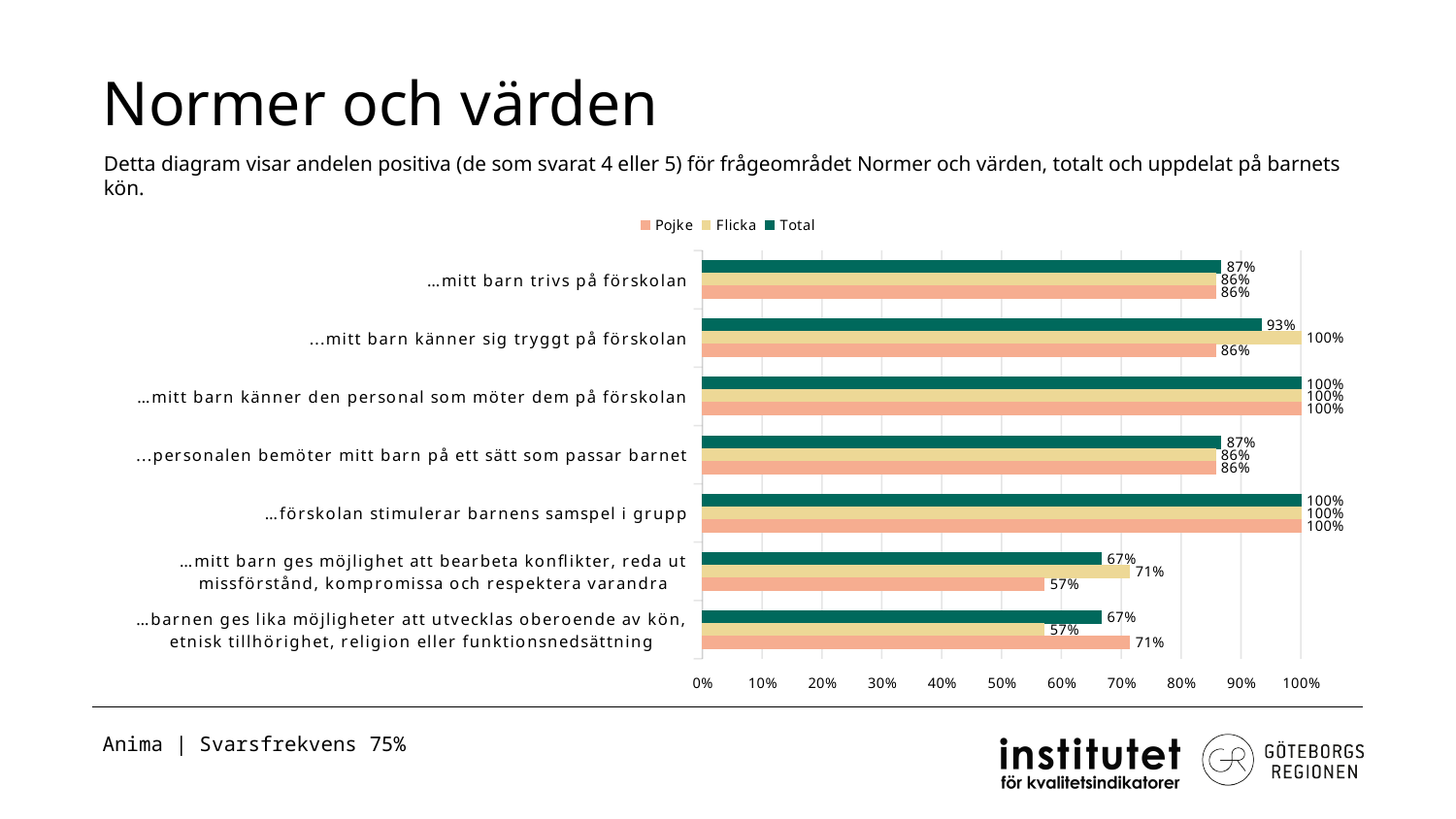
What is the Total value for "…mitt barn trivs på förskolan"? 87% How many series does the legend list? 3 What is the difference between the Flicka and Pojke values for "...mitt barn känner sig tryggt på förskolan"? 14 percentage points What is the Pojke value for "…barnen ges lika möjligheter att utvecklas oberoende av kön, etnisk tillhörighet, religion eller funktionsnedsättning"? 71% What is the Flicka value for "...mitt barn känner sig tryggt på förskolan"? 100% What is the Pojke value for "…mitt barn ges möjlighet att bearbeta konflikter, reda ut missförstånd, kompromissa och respektera varandra"? 57% For "…mitt barn ges möjlighet att bearbeta konflikter, reda ut missförstånd, kompromissa och respektera varandra", which is larger, the Flicka value or the Pojke value? Flicka How many categories (statements) are plotted in the chart? 7 What is the Total value for "...mitt barn känner sig tryggt på förskolan"? 93% What kind of chart is shown on the slide? bar chart Which series is shown in dark green in the legend? Total